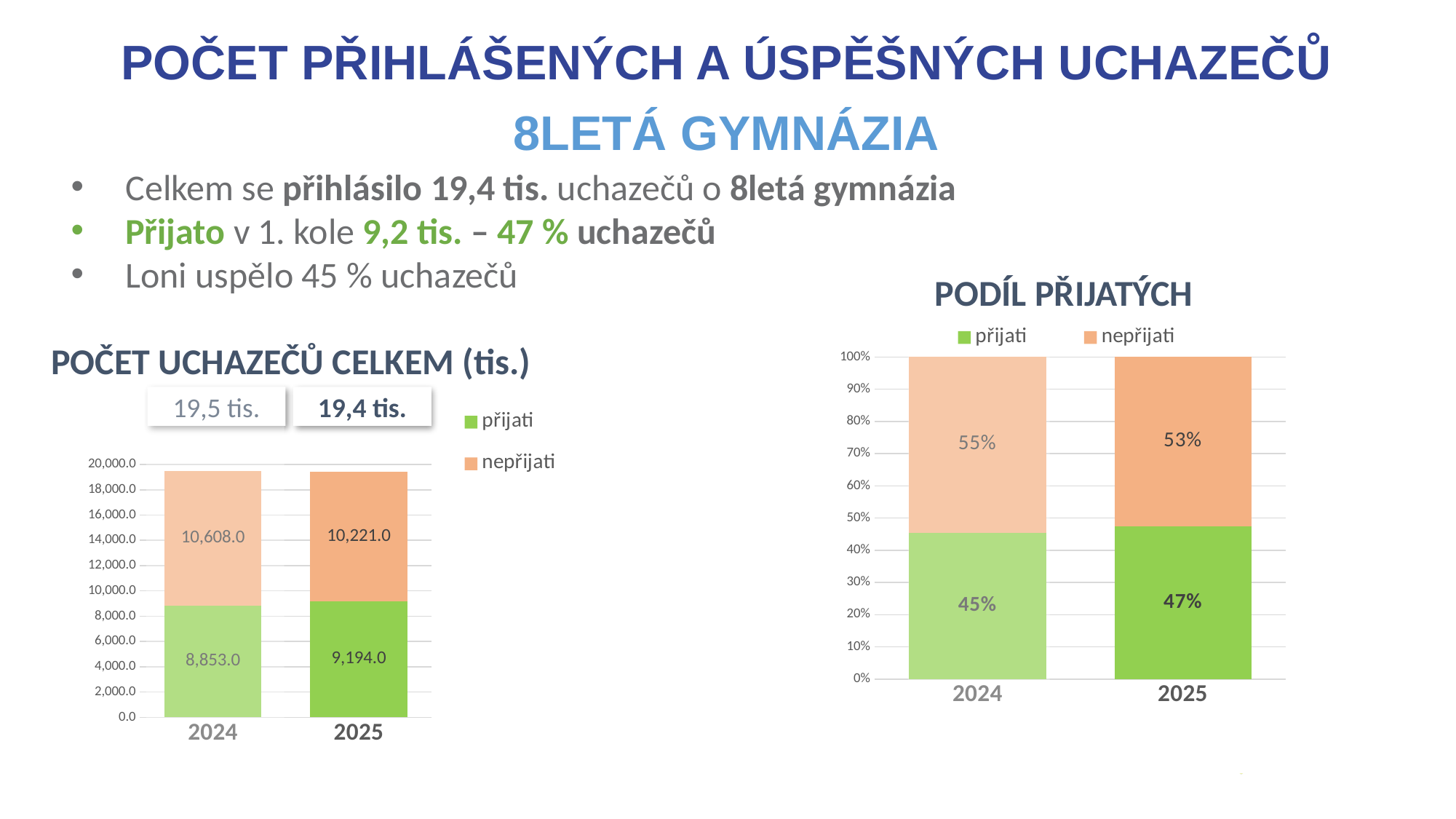
In the chart titled PODÍL PŘIJATÝCH, what is the share of nepřijati in 2025? 53% In the chart titled PODÍL PŘIJATÝCH, does the share of přijati rise or fall from 2024 to 2025? rise In the chart titled POČET UCHAZEČŮ CELKEM (tis.), what is the difference between nepřijati and přijati in 2024? 1,755.0 In the chart titled POČET UCHAZEČŮ CELKEM (tis.), how many series does the legend list? 2 In the chart titled POČET UCHAZEČŮ CELKEM (tis.), what is the value for nepřijati in 2024? 10,608.0 In the chart titled POČET UCHAZEČŮ CELKEM (tis.), what is the total of the stacked bar for 2025? 19,415.0 What kind of chart is the chart titled PODÍL PŘIJATÝCH? stacked bar chart In the chart titled POČET UCHAZEČŮ CELKEM (tis.), which colour represents nepřijati? orange In the chart titled POČET UCHAZEČŮ CELKEM (tis.), what is the value for přijati in 2025? 9,194.0 In the chart titled POČET UCHAZEČŮ CELKEM (tis.), which year has the higher value for přijati? 2025 In the chart titled PODÍL PŘIJATÝCH, what is the share of přijati in 2024? 45% In the chart titled PODÍL PŘIJATÝCH, how many categories are shown on the x axis? 2